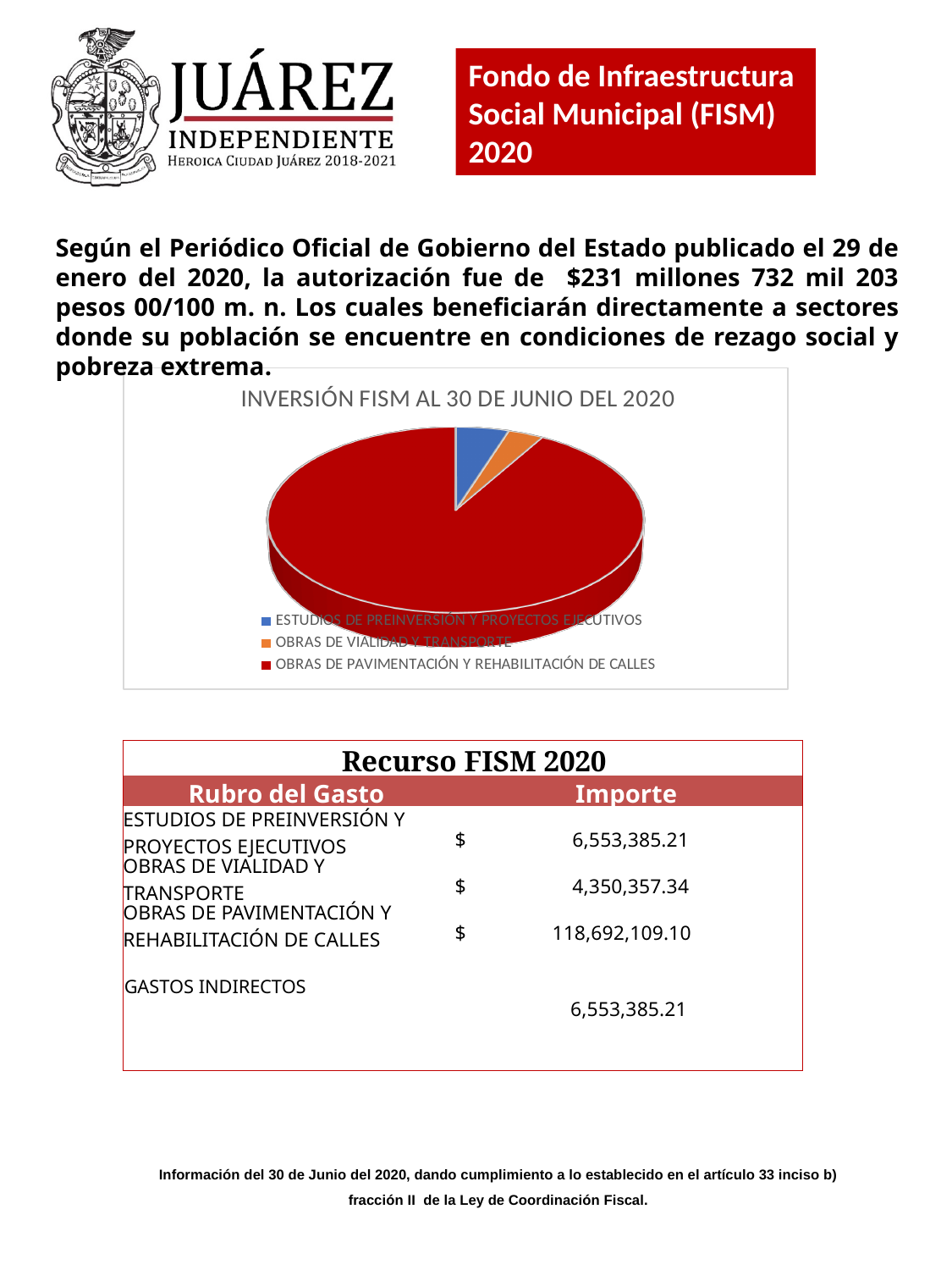
What colour is the slice for OBRAS DE PAVIMENTACIÓN Y REHABILITACIÓN DE CALLES in the pie chart? red What is the title of the pie chart? INVERSIÓN FISM AL 30 DE JUNIO DEL 2020 In the pie chart, which slice is larger: ESTUDIOS DE PREINVERSIÓN Y PROYECTOS EJECUTIVOS or OBRAS DE VIALIDAD Y TRANSPORTE? ESTUDIOS DE PREINVERSIÓN Y PROYECTOS EJECUTIVOS What kind of chart is shown on the slide? pie chart How many entries does the pie chart's legend list? 3 In the pie chart, which slice is larger: OBRAS DE PAVIMENTACIÓN Y REHABILITACIÓN DE CALLES or ESTUDIOS DE PREINVERSIÓN Y PROYECTOS EJECUTIVOS? OBRAS DE PAVIMENTACIÓN Y REHABILITACIÓN DE CALLES Which category has the smallest slice in the pie chart? OBRAS DE VIALIDAD Y TRANSPORTE How many slices does the pie chart have? 3 Which category has the largest slice in the pie chart? OBRAS DE PAVIMENTACIÓN Y REHABILITACIÓN DE CALLES